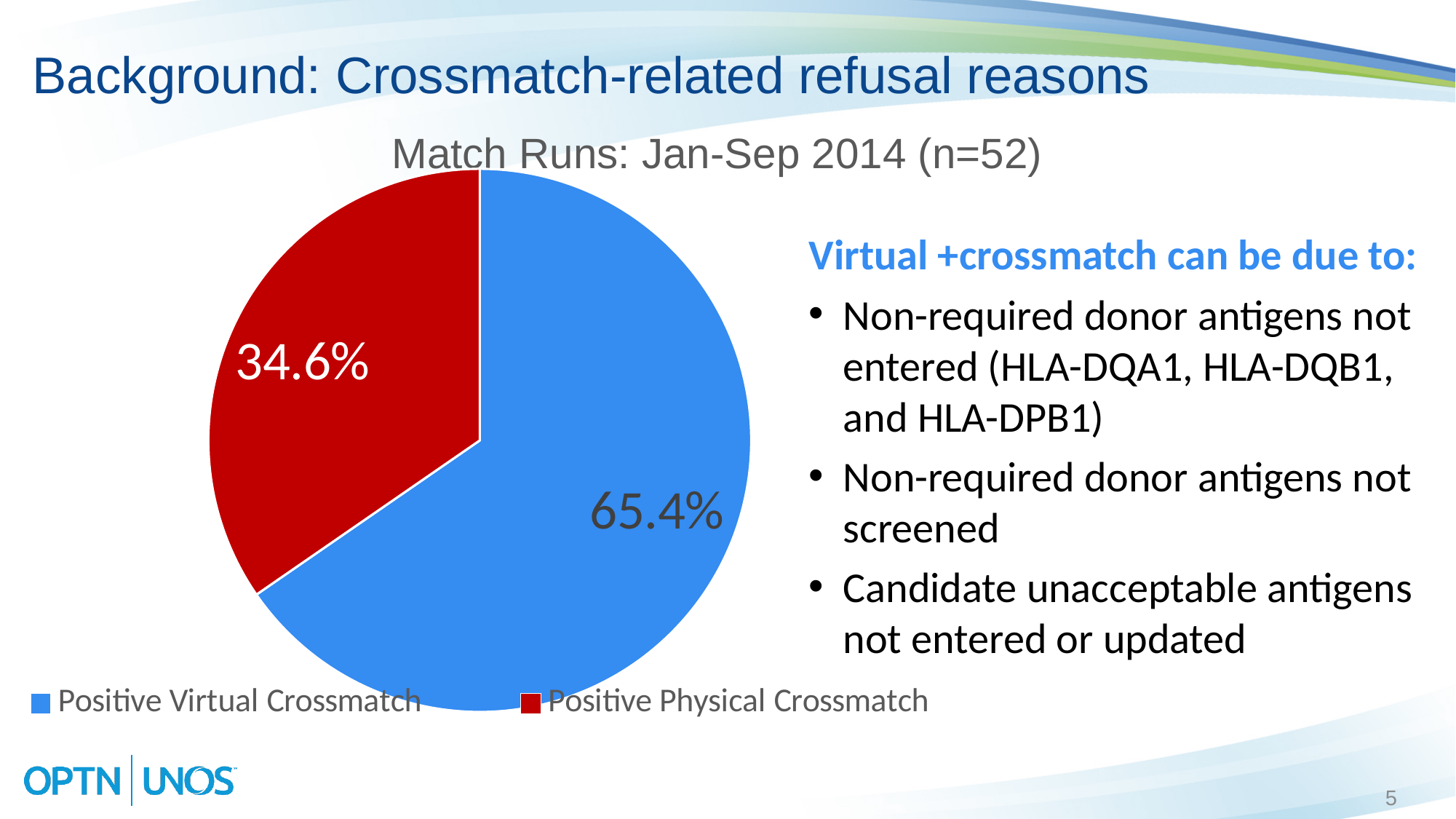
Which slice of the pie is the smallest? Positive Physical Crossmatch What is the difference in percentage points between the Positive Virtual Crossmatch and Positive Physical Crossmatch slices? 30.8 Which slice of the pie is the largest? Positive Virtual Crossmatch What kind of chart is shown on the slide? pie chart What is the title of the pie chart? Match Runs: Jan-Sep 2014 (n=52) How many entries does the legend list? 2 What share of the pie is Positive Virtual Crossmatch? 65.4% How many slices does the pie chart have? 2 What share of the pie is Positive Physical Crossmatch? 34.6% What colour is the Positive Physical Crossmatch slice? red Which is larger, Positive Virtual Crossmatch or Positive Physical Crossmatch? Positive Virtual Crossmatch